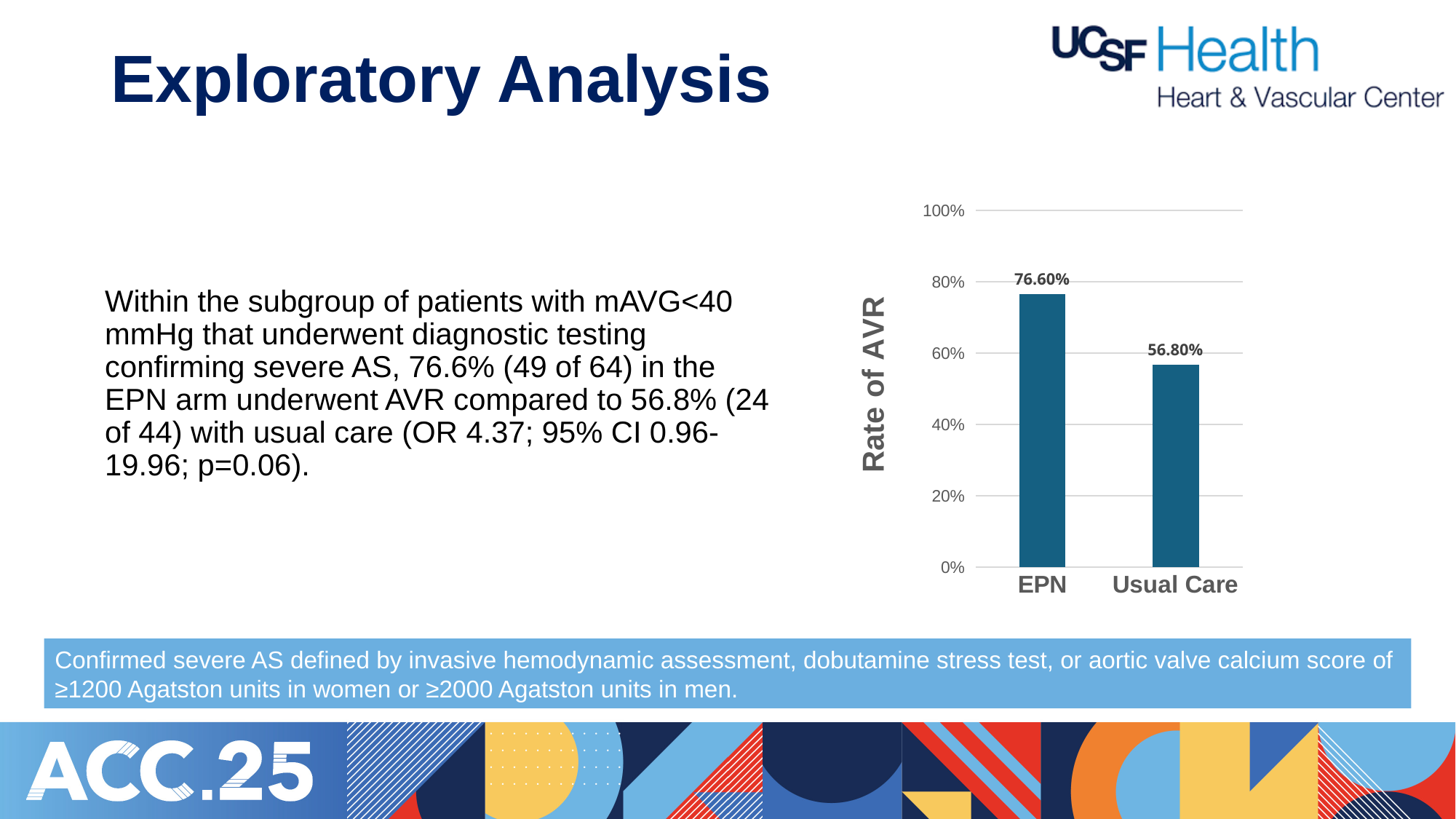
Is the rate of AVR for EPN greater or less than 80%? less What is the rate of AVR for the Usual Care group? 56.80% Is the rate of AVR larger for EPN or for Usual Care? EPN What kind of chart is shown on the slide? bar chart What is the maximum value shown on the y axis of the chart? 100% How many groups are shown on the x axis of the chart? 2 Is the rate of AVR for Usual Care greater or less than 60%? less Which group has the lower rate of AVR? Usual Care What is the label of the y axis of the chart? Rate of AVR Which group has the higher rate of AVR? EPN What is the difference in rate of AVR between EPN and Usual Care? 19.80% What is the rate of AVR for the EPN group? 76.60%